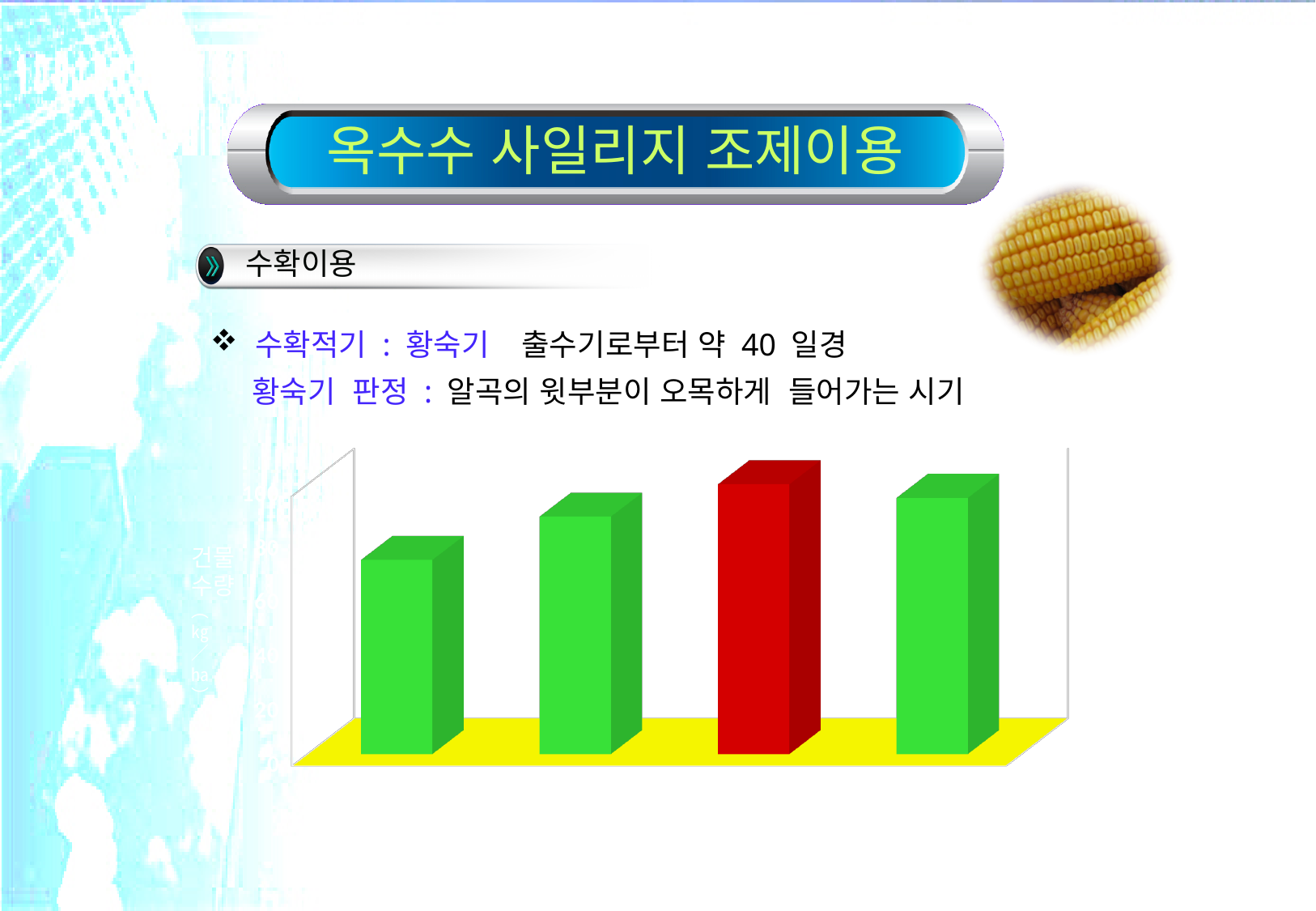
Is the value of the third bar from the left greater or less than 80? greater Is the second bar from the left taller or shorter than the first bar? taller How many bars are plotted in the chart? 4 Is the third bar from the left taller or shorter than the second bar? taller What colour is the third bar from the left in the chart? red Which bar in the chart is the tallest, counting from the left? the third bar Is the value of the first bar from the left greater or less than 40? greater Which bar in the chart is the shortest, counting from the left? the first bar What kind of chart is shown on the slide? bar chart Is the fourth bar from the left taller or shorter than the third bar? shorter How many of the bars in the chart are green? 3